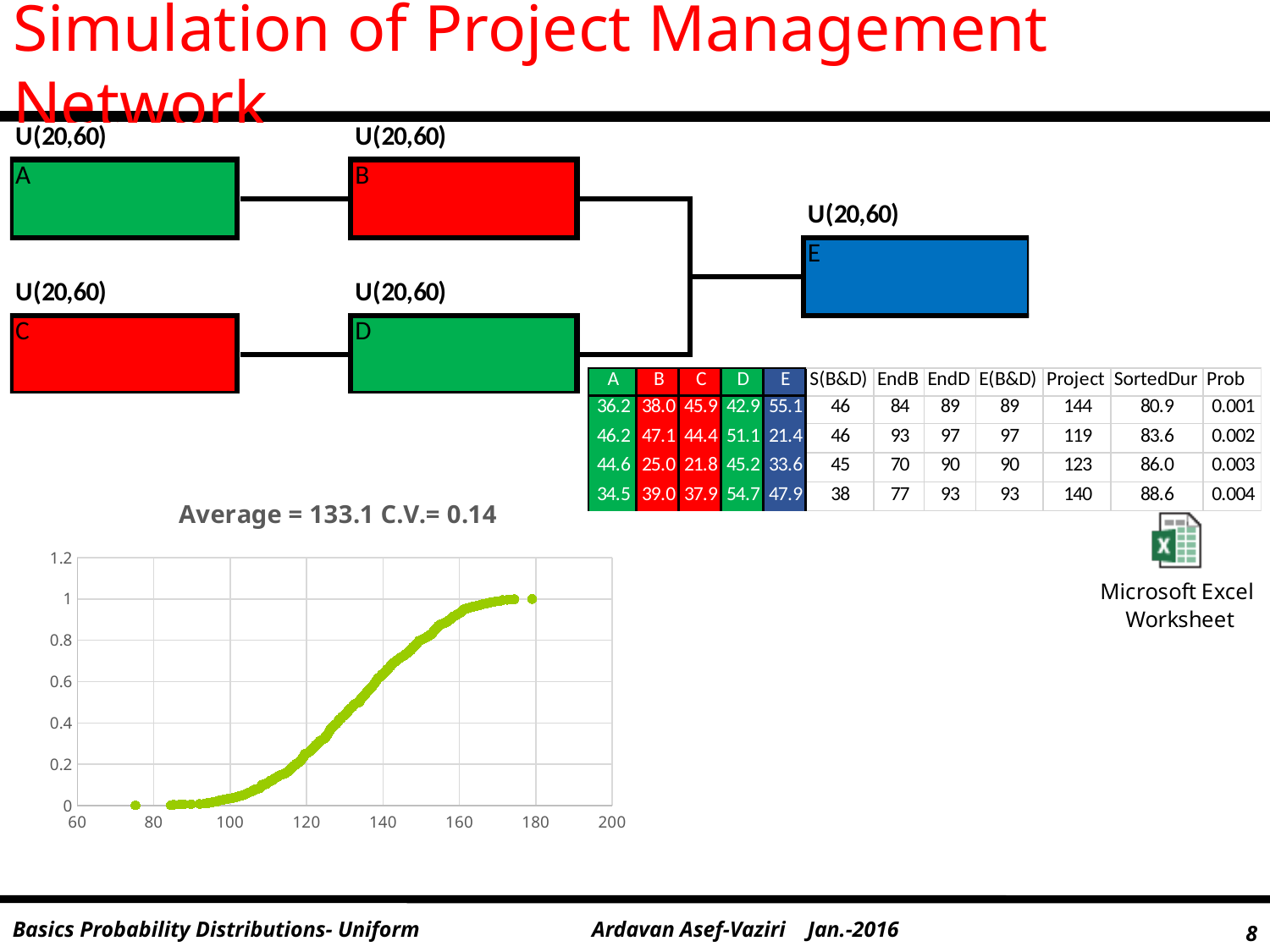
In the chart titled 'Average = 133.1 C.V.= 0.14', do the plotted values rise or fall as the x axis increases? rise In the chart titled 'Average = 133.1 C.V.= 0.14', is the plotted value at x = 100 greater or less than 0.2? less In the chart titled 'Average = 133.1 C.V.= 0.14', is the plotted value at x = 160 greater or less than 0.8? greater What is the title of the chart at the bottom left of the slide? Average = 133.1 C.V.= 0.14 In the chart titled 'Average = 133.1 C.V.= 0.14', is the plotted value at x = 180 greater or less than 0.6? greater What kind of chart is shown at the bottom left of the slide? scatter chart In the chart titled 'Average = 133.1 C.V.= 0.14', what is the highest value shown on the y axis? 1.2